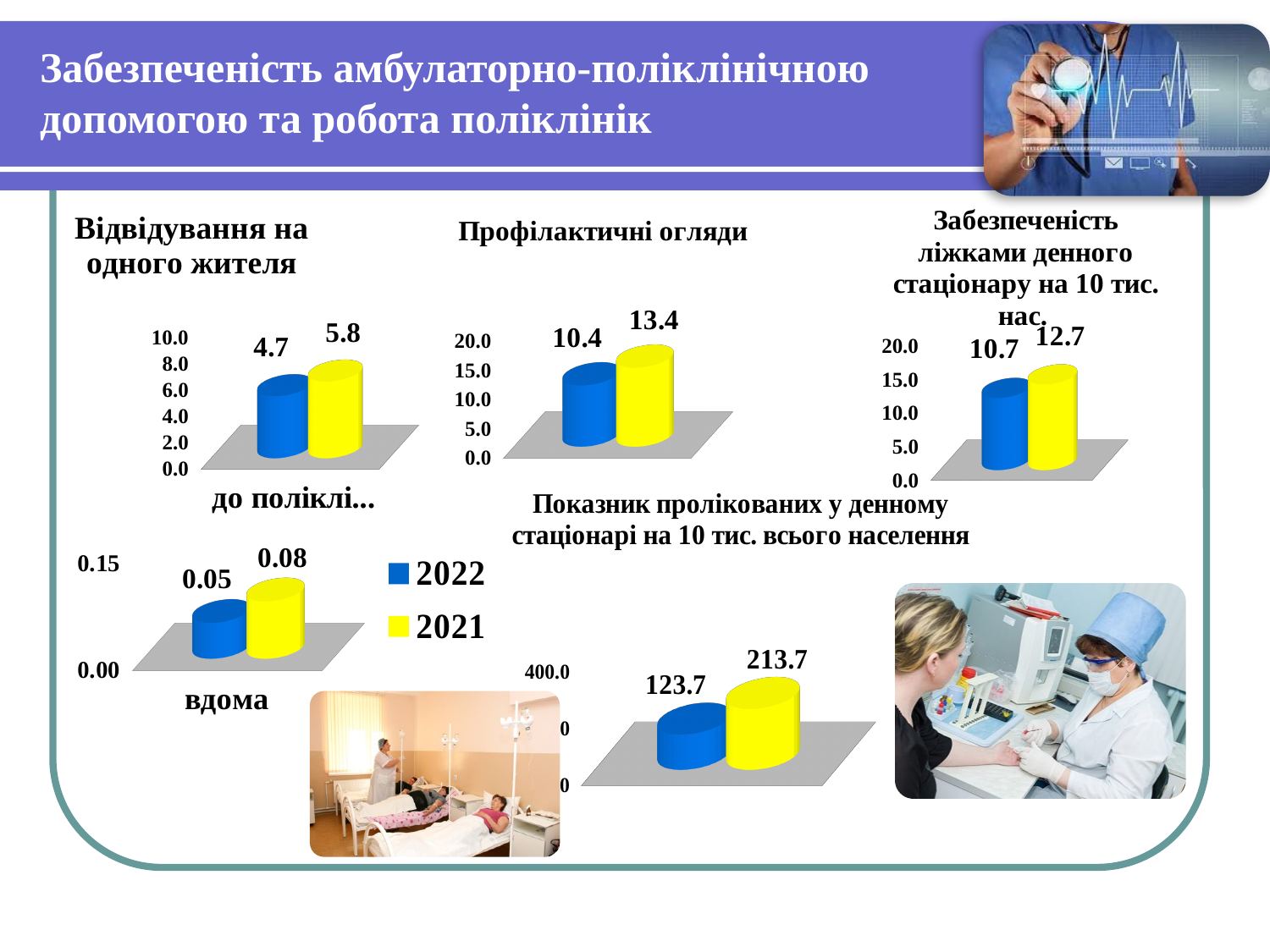
In the 'Забезпеченість ліжками денного стаціонару на 10 тис. нас.' chart, what is the value for 2021? 12.7 In the 'Профілактичні огляди' chart, what is the value for 2022? 10.4 In the 'Профілактичні огляди' chart, what is the value for 2021? 13.4 What colour represents 2021 in the charts on the slide? Yellow In the 'до поліклі...' chart under 'Відвідування на одного жителя', what is the value for 2022? 4.7 In the 'до поліклі...' chart, which year has the higher value, 2022 or 2021? 2021 In the 'Показник пролікованих у денному стаціонарі на 10 тис. всього населення' chart, what is the value for 2022? 123.7 In the 'Забезпеченість ліжками денного стаціонару на 10 тис. нас.' chart, what is the difference between the 2021 and 2022 values? 2.0 In the 'вдома' chart, what is the difference between the 2021 and 2022 values? 0.03 How many series does the legend on the slide list? 2 In the 'Показник пролікованих у денному стаціонарі на 10 тис. всього населення' chart, what is the difference between the 2021 and 2022 values? 90.0 In the 'вдома' chart, what is the value for 2021? 0.08